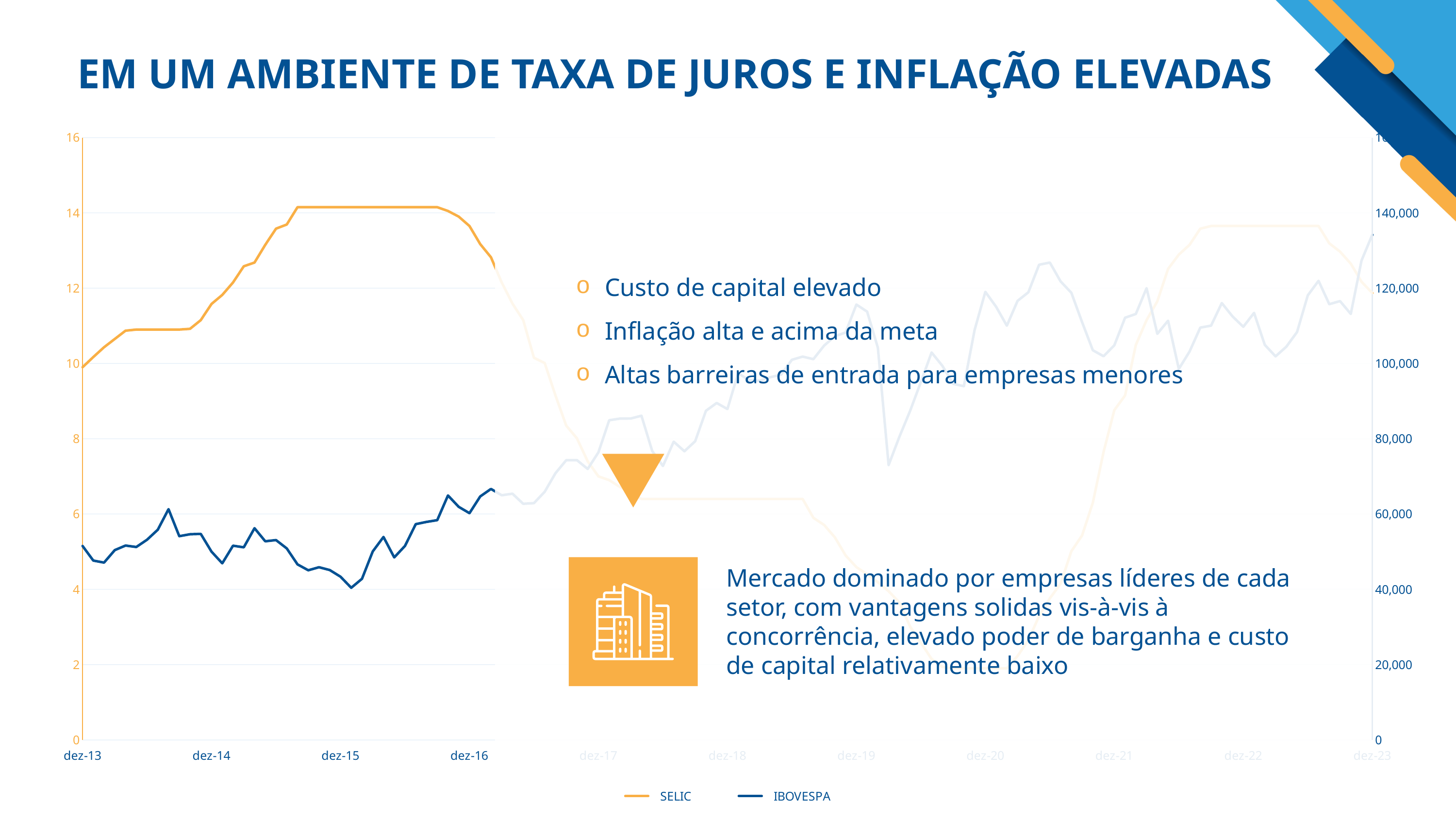
Does the SELIC line rise or fall between dez-13 and dez-15? rise How many series does the chart legend list? 2 Is the IBOVESPA value at dez-15 greater or less than 60,000? less Is the SELIC value at dez-15 greater or less than 12? greater Is the SELIC value at dez-13 greater or less than 12? less What colour is the SELIC line in the chart? orange How many date labels are shown on the x axis of the chart? 11 Is the SELIC value higher at dez-13 or at dez-15? dez-15 What kind of chart is shown on the slide? line chart Which two series are listed in the chart legend? SELIC and IBOVESPA Among the labelled dates dez-13, dez-14, dez-15 and dez-16, at which is the SELIC value highest? dez-15